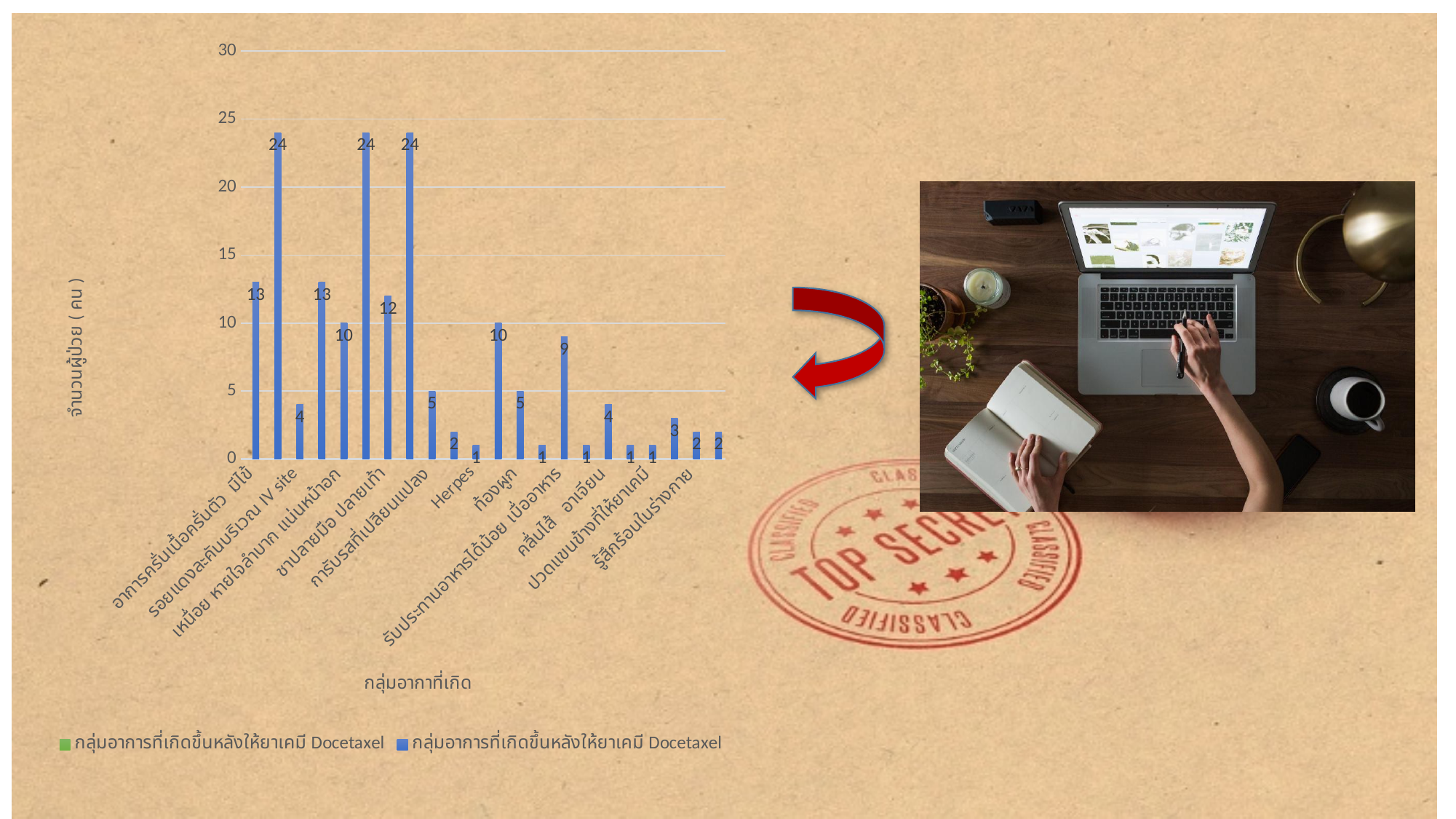
What is the highest value shown by any bar in the chart? 24 What is the lowest value shown by any bar in the chart? 1 What is the difference between the highest bar value (24) and the lowest bar value (1)? 23 How many bars in the chart reach the highest value of 24? 3 How many bars are plotted in the chart? 22 What is the title of the horizontal axis? กลุ่มอากาที่เกิด What is the highest tick value shown on the vertical axis? 30 How many series does the legend list? 2 Is the tallest bar in the chart greater or less than 20? greater How many bars in the chart have a value of 1? 5 What kind of chart is shown on the slide? bar chart